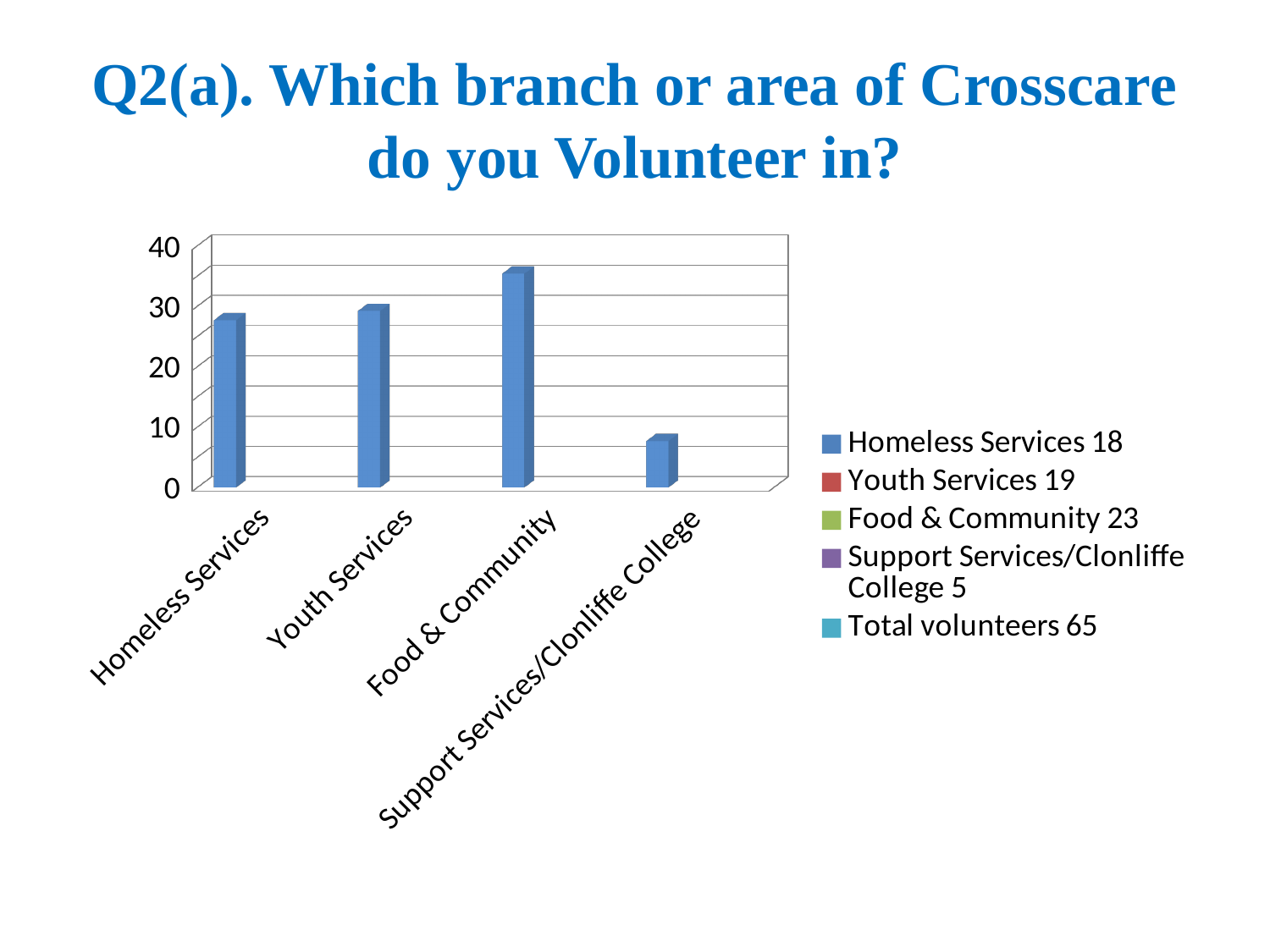
Which category has the tallest bar? Food & Community Is the value for Food & Community greater or less than 30? greater What is the title of the slide containing the chart? Q2(a). Which branch or area of Crosscare do you Volunteer in? What kind of chart is shown on the slide? bar chart How many bars are plotted in the chart? 4 Which bar is taller, Food & Community or Homeless Services? Food & Community What number does the legend show next to Total volunteers? 65 Is the value for Support Services/Clonliffe College greater or less than 10? less Is the value for Homeless Services greater or less than 20? greater How many entries does the chart's legend list? 5 Which category has the shortest bar? Support Services/Clonliffe College Which bar is taller, Youth Services or Support Services/Clonliffe College? Youth Services